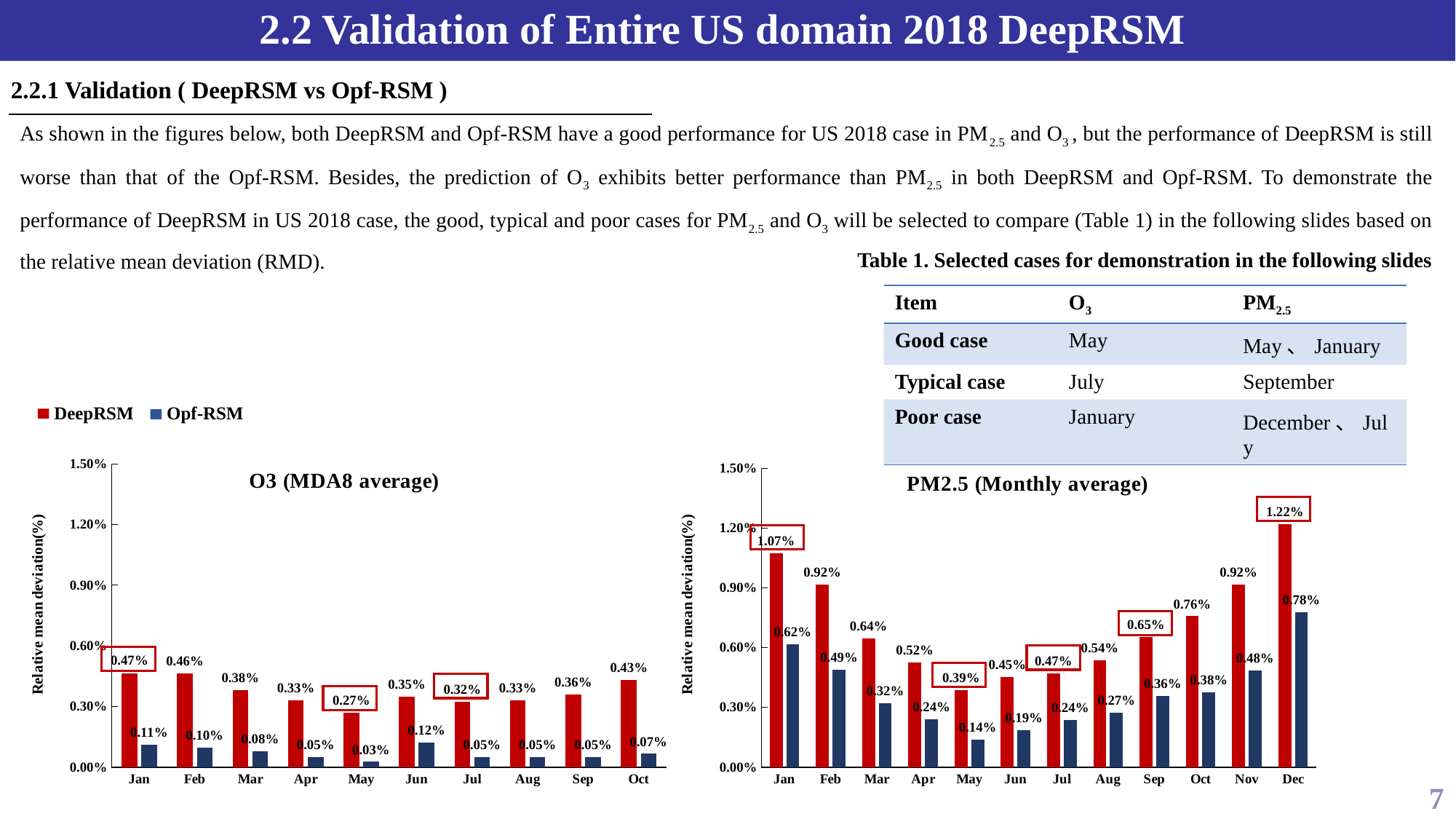
In the O3 (MDA8 average) chart, what is the DeepRSM value for May? 0.27% How many series does the legend list for the charts on this slide? 2 In the PM2.5 (Monthly average) chart, what is the DeepRSM value for Dec? 1.22% In the PM2.5 (Monthly average) chart, which is larger, the Opf-RSM value for Jan or the Opf-RSM value for Nov? Jan In the O3 (MDA8 average) chart, which month has the highest DeepRSM value? Jan How many months are shown on the x axis of the O3 (MDA8 average) chart? 10 In the O3 (MDA8 average) chart, what is the difference between the DeepRSM and Opf-RSM values for Oct? 0.36% In the O3 (MDA8 average) chart, which month has the lowest Opf-RSM value? May In the PM2.5 (Monthly average) chart, what is the difference between the DeepRSM and Opf-RSM values for Jan? 0.45% In the O3 (MDA8 average) chart, what is the Opf-RSM value for Jun? 0.12% In the PM2.5 (Monthly average) chart, what is the Opf-RSM value for Sep? 0.36% In the PM2.5 (Monthly average) chart, which month has the lowest DeepRSM value? May